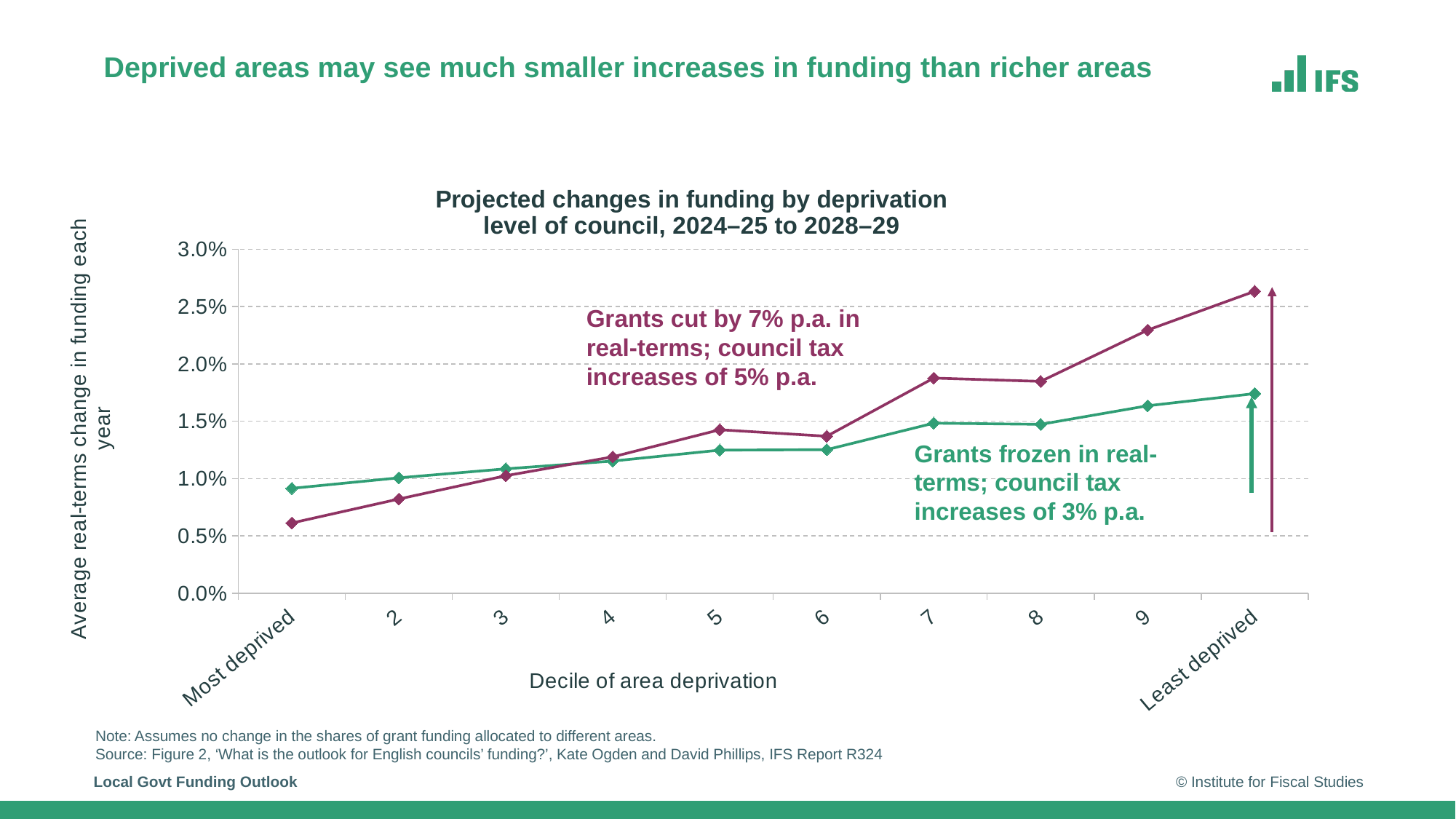
What kind of chart is shown on the slide? Line chart Is the value for decile 7 on the 'Grants cut by 7% p.a.' line greater or less than 2.0%? less At the 'Most deprived' decile, which line is higher: 'Grants cut by 7% p.a.' or 'Grants frozen in real-terms'? Grants frozen in real-terms Do the values on the 'Grants cut by 7% p.a.' line generally rise or fall from the most deprived to the least deprived decile? Rise Is the value for the 'Least deprived' decile on the 'Grants frozen in real-terms' line greater or less than 1.5%? greater Which decile has the lowest value on the 'Grants frozen in real-terms' line? Most deprived Is the value for the 'Least deprived' decile on the 'Grants cut by 7% p.a.' line greater or less than 2.5%? greater What is the title of the chart? Projected changes in funding by deprivation level of council, 2024–25 to 2028–29 How many series (lines) does the chart plot? 2 Which decile has the highest value on the 'Grants cut by 7% p.a.' line? Least deprived How many deciles of area deprivation are plotted along the x axis? 10